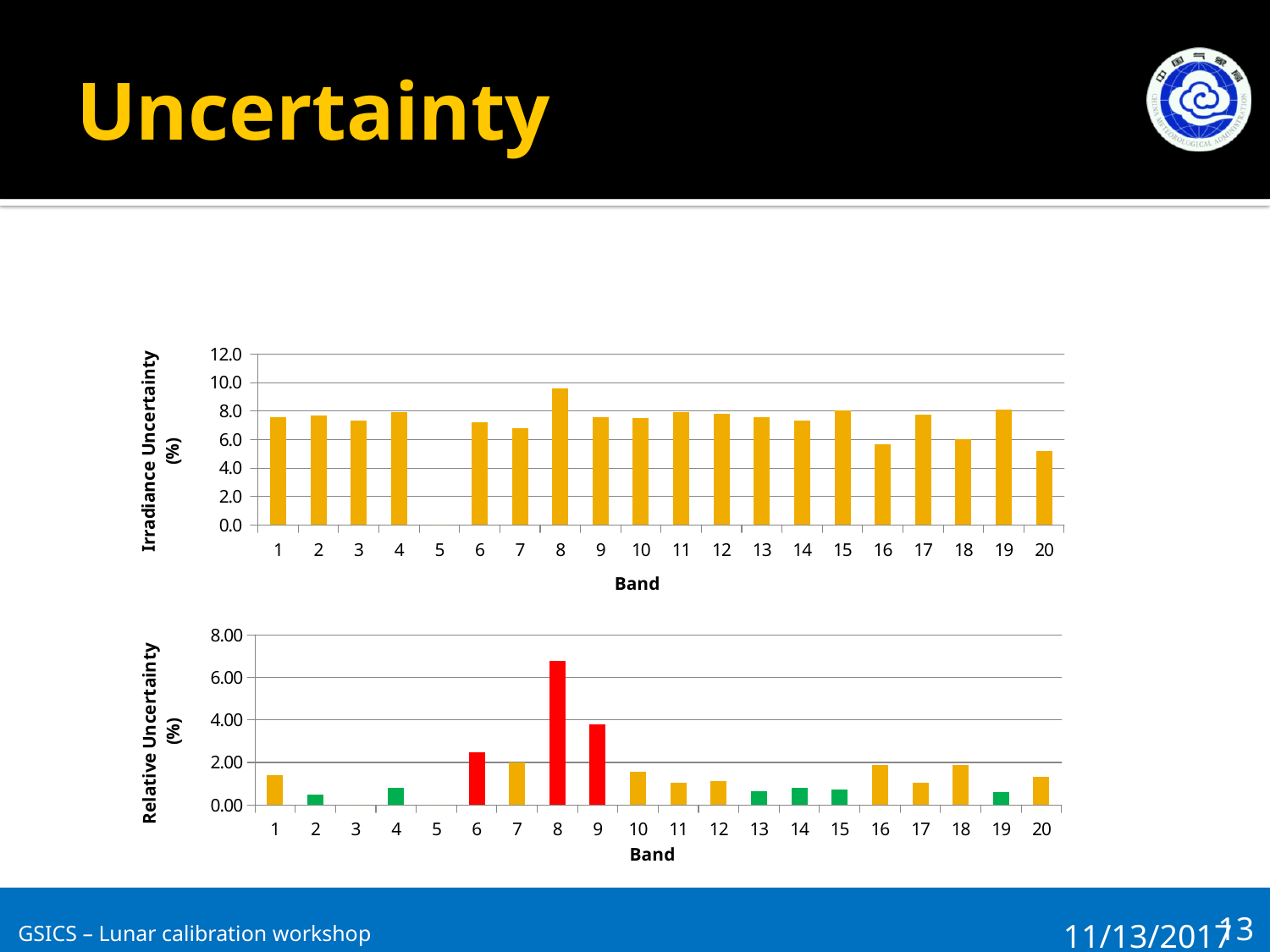
How many band categories are shown on the x axis of the top chart (Irradiance Uncertainty)? 20 In the bottom chart (Relative Uncertainty), is the value for band 1 greater or less than 2.00? less In the bottom chart (Relative Uncertainty), is the value for band 8 greater or less than 6.00? greater In the bottom chart (Relative Uncertainty), which is larger, the value for band 8 or the value for band 9? Band 8 In the bottom chart (Relative Uncertainty), is the value for band 6 greater or less than 2.00? greater In the top chart (Irradiance Uncertainty), which band has the highest irradiance uncertainty? Band 8 In the top chart (Irradiance Uncertainty), which is larger, the value for band 8 or the value for band 20? Band 8 What kind of chart is the bottom chart (Relative Uncertainty)? Bar chart In the bottom chart (Relative Uncertainty), which band has the highest relative uncertainty? Band 8